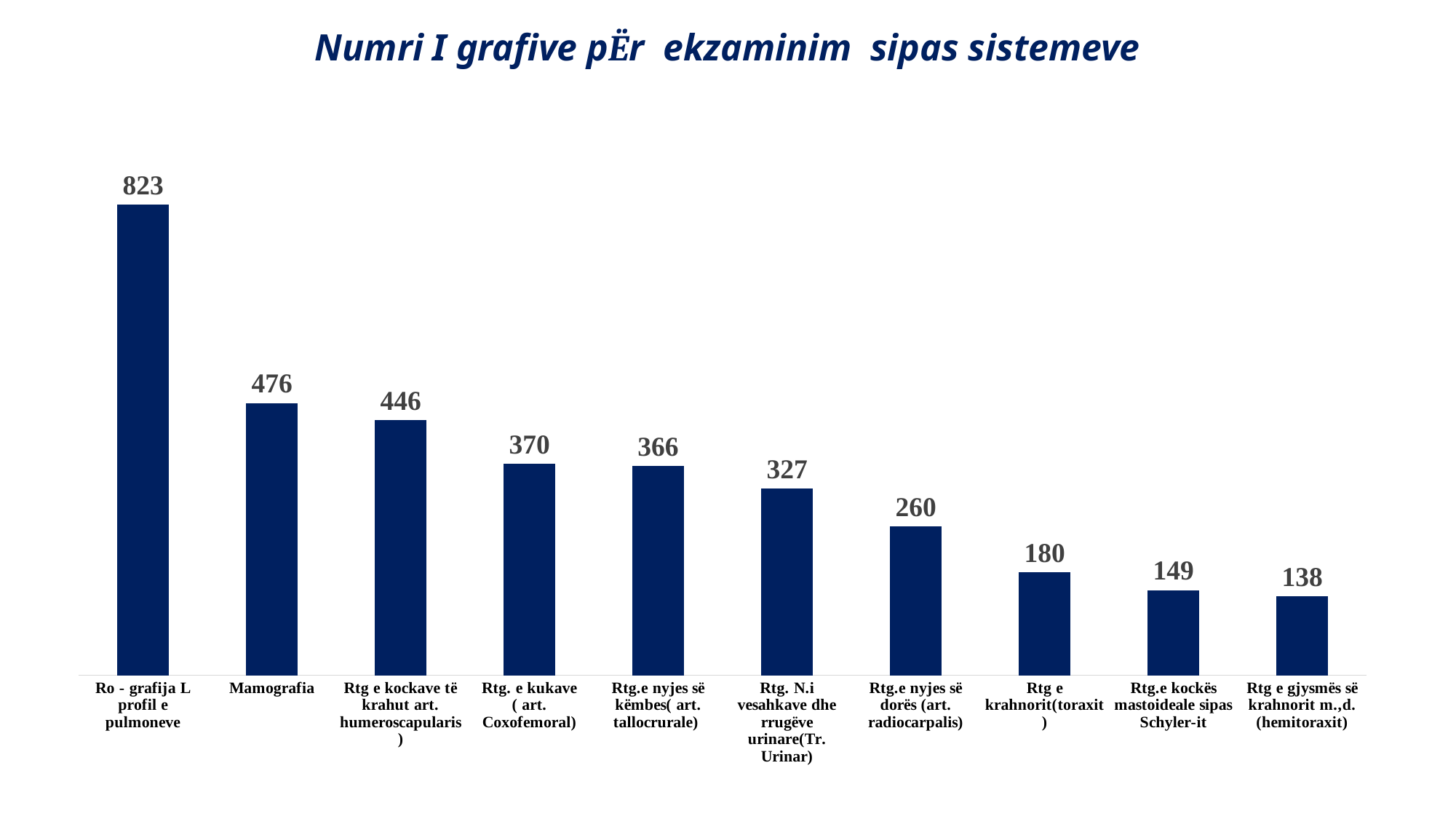
Which category has the lowest value? Rtg e gjysmës së krahnorit m.,d. (hemitoraxit) What is the difference between the values for Rtg.e nyjes së dorës (art. radiocarpalis) and Rtg e krahnorit(toraxit)? 80 How many categories are shown in the chart? 10 Which category has the highest value? Ro - grafija L profil e pulmoneve What is the value for Rtg.e kockës mastoideale sipas Schyler-it? 149 Do the values rise or fall from left to right along the x axis? Fall What is the value for Rtg e krahnorit(toraxit)? 180 What is the value for Mamografia? 476 What kind of chart is shown on the slide? Bar chart What is the difference between the values for Ro - grafija L profil e pulmoneve and Mamografia? 347 Which is larger, the value for Rtg e kockave të krahut art. humeroscapularis) or the value for Rtg.e nyjes së këmbes( art. tallocrurale)? Rtg e kockave të krahut art. humeroscapularis) What is the value for Rtg. e kukave ( art. Coxofemoral)? 370